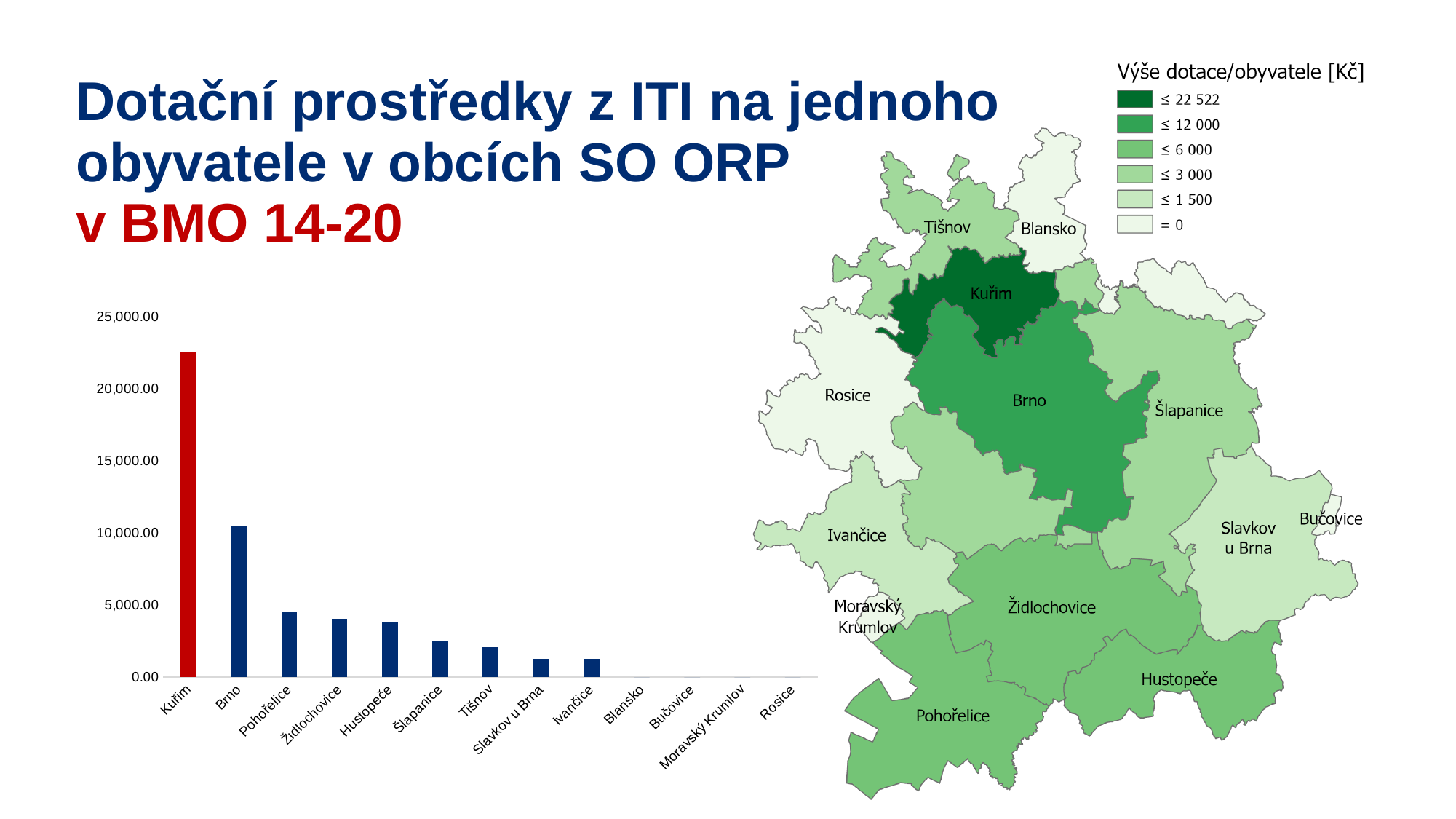
Which category has the highest value in the bar chart? Kuřim Is the value for Tišnov greater or less than 5,000? less Is the value for Kuřim greater or less than 20,000? greater Which has a larger value, Kuřim or Brno? Kuřim Is the value for Pohořelice greater or less than 5,000? less What kind of chart is shown on the left of the slide? bar chart Which has a larger value, Šlapanice or Tišnov? Šlapanice Do the values in the bar chart rise or fall from left to right along the x axis? fall Which bar in the bar chart is coloured red rather than blue? Kuřim How many categories are shown on the x axis of the bar chart? 13 Which has a larger value, Brno or Pohořelice? Brno